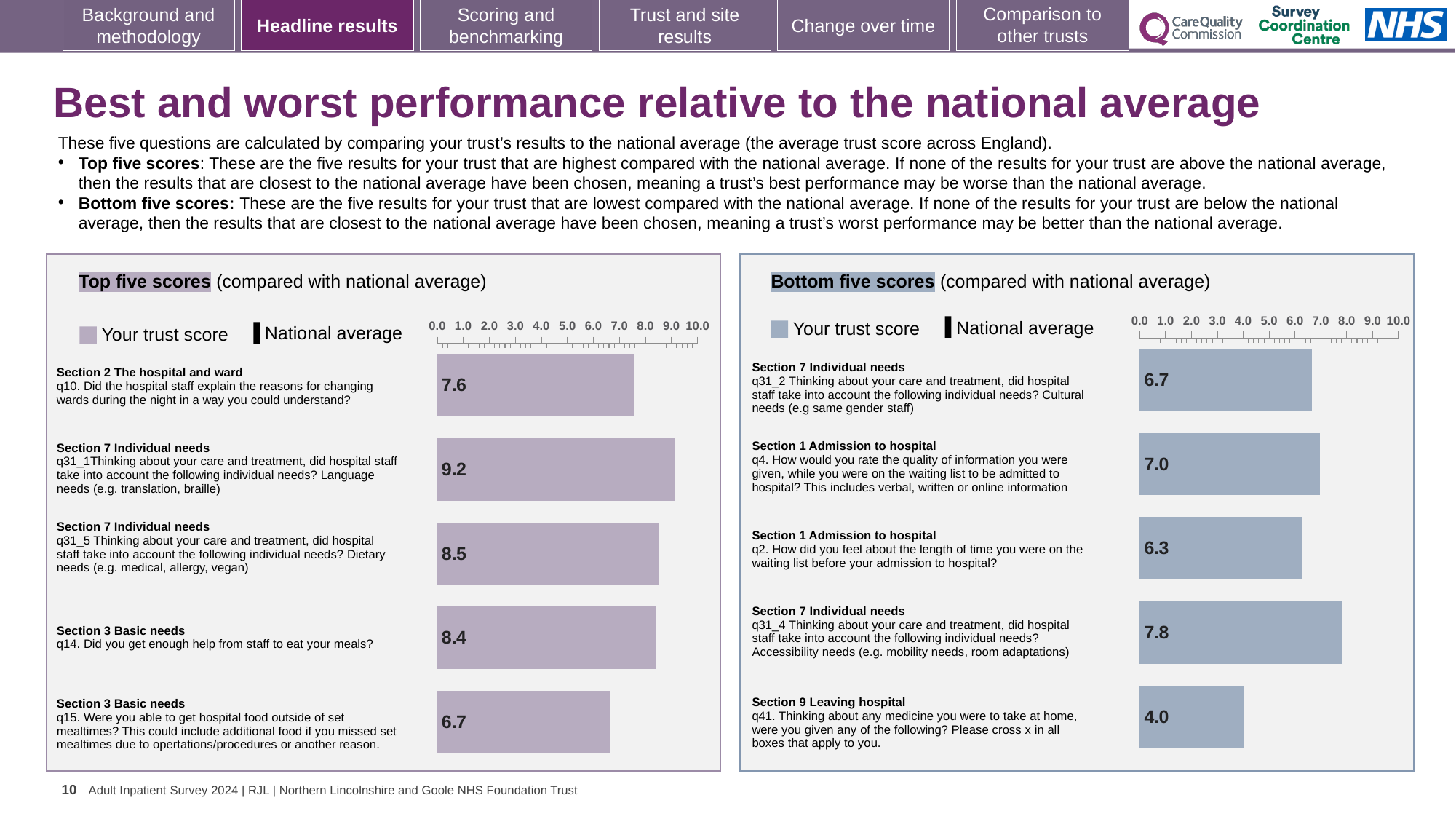
How many bars are plotted in the Top five scores chart? 5 In the Bottom five scores chart, which has the higher trust score: q4 (quality of information on the waiting list) or q2 (length of time on the waiting list)? q4 (7.0) In the Top five scores chart, what is the trust score for q10 (explaining reasons for changing wards during the night)? 7.6 In the Top five scores chart, what is the difference between the scores for q31_1 (Language needs) and q15 (food outside of set mealtimes)? 2.5 In the Top five scores chart, what is the trust score for q14 (Did you get enough help from staff to eat your meals?)? 8.4 In the Bottom five scores chart, is the trust score for q31_4 (Accessibility needs) greater or less than 7.0? greater In the Bottom five scores chart, which question has the lowest trust score? q41 (4.0) In the Bottom five scores chart, what is the trust score for q41 (medicine to take at home)? 4.0 In the Top five scores chart, which question has the highest trust score? q31_1 Language needs (9.2) What two entries does the legend of the Top five scores chart list? Your trust score and National average In the Bottom five scores chart, what is the difference between the scores for q31_4 (Accessibility needs) and q41 (medicine to take at home)? 3.8 What type of chart is the Bottom five scores chart? Bar chart